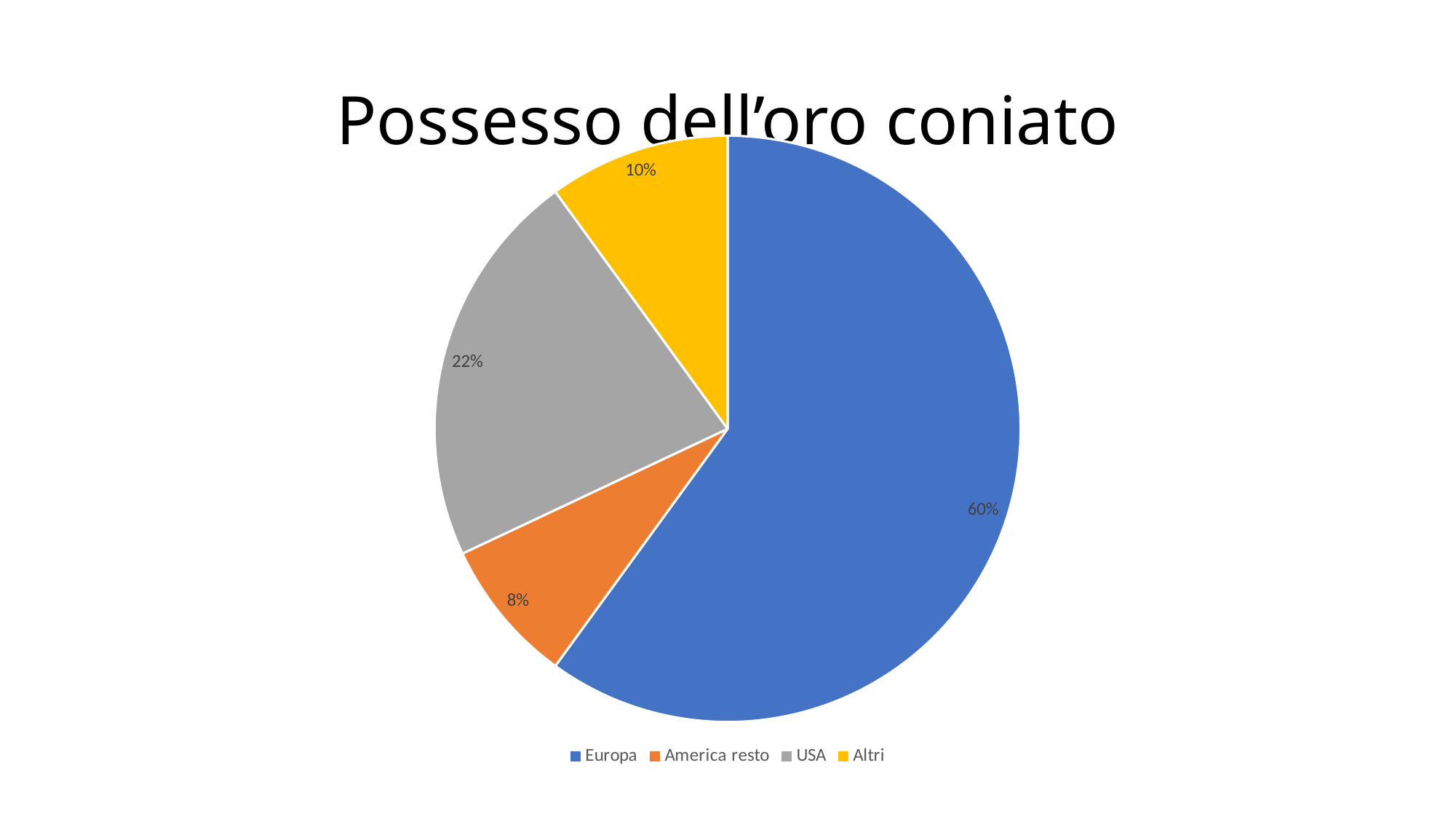
Which category has the smallest slice? America resto What is the value shown for USA? 22% What is the value shown for Altri? 10% What is the value shown for America resto? 8% Which is larger, the USA slice or the Altri slice? USA How many categories does the pie chart have? 4 Which category has the largest slice? Europa What is the title of the chart? Possesso dell'oro coniato What is the difference between the Europa and USA shares? 38% Which colour represents Altri in the legend? yellow What share of the pie does Europa hold? 60% What kind of chart is shown on the slide? pie chart